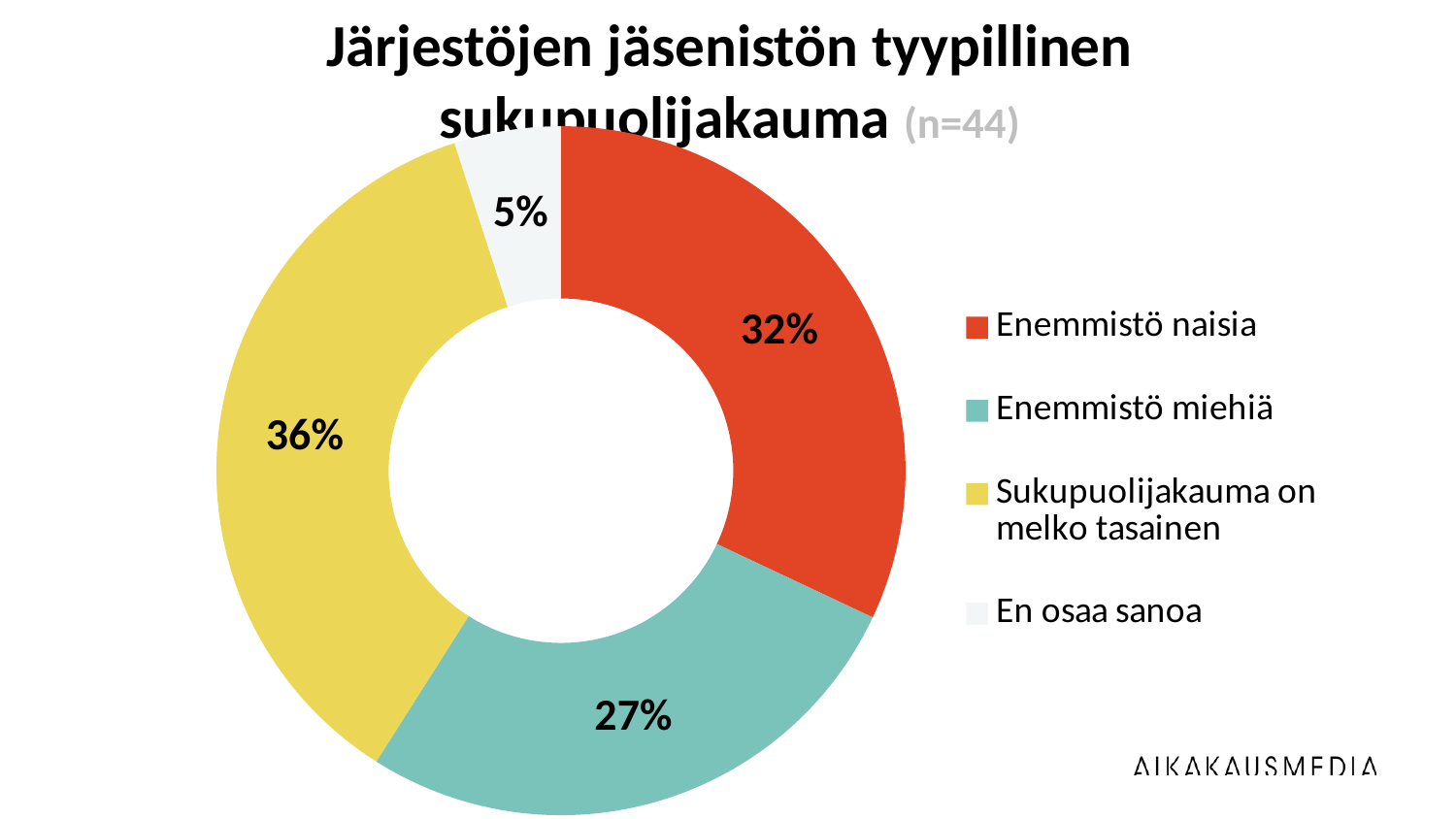
What share of the chart is 'En osaa sanoa'? 5% Which is larger, 'Enemmistö naisia' or 'Enemmistö miehiä'? Enemmistö naisia What colour is the slice for 'Enemmistö naisia'? Red What is the title of the chart? Järjestöjen jäsenistön tyypillinen sukupuolijakauma (n=44) Which category has the smallest share? En osaa sanoa What kind of chart is shown on the slide? Pie chart (doughnut) What is the difference in percentage points between 'Sukupuolijakauma on melko tasainen' and 'Enemmistö miehiä'? 9 What share of the chart is 'Enemmistö miehiä'? 27% How many categories does the chart show? 4 What share of the chart is 'Sukupuolijakauma on melko tasainen'? 36% Which category has the largest share? Sukupuolijakauma on melko tasainen What share of the chart is 'Enemmistö naisia'? 32%